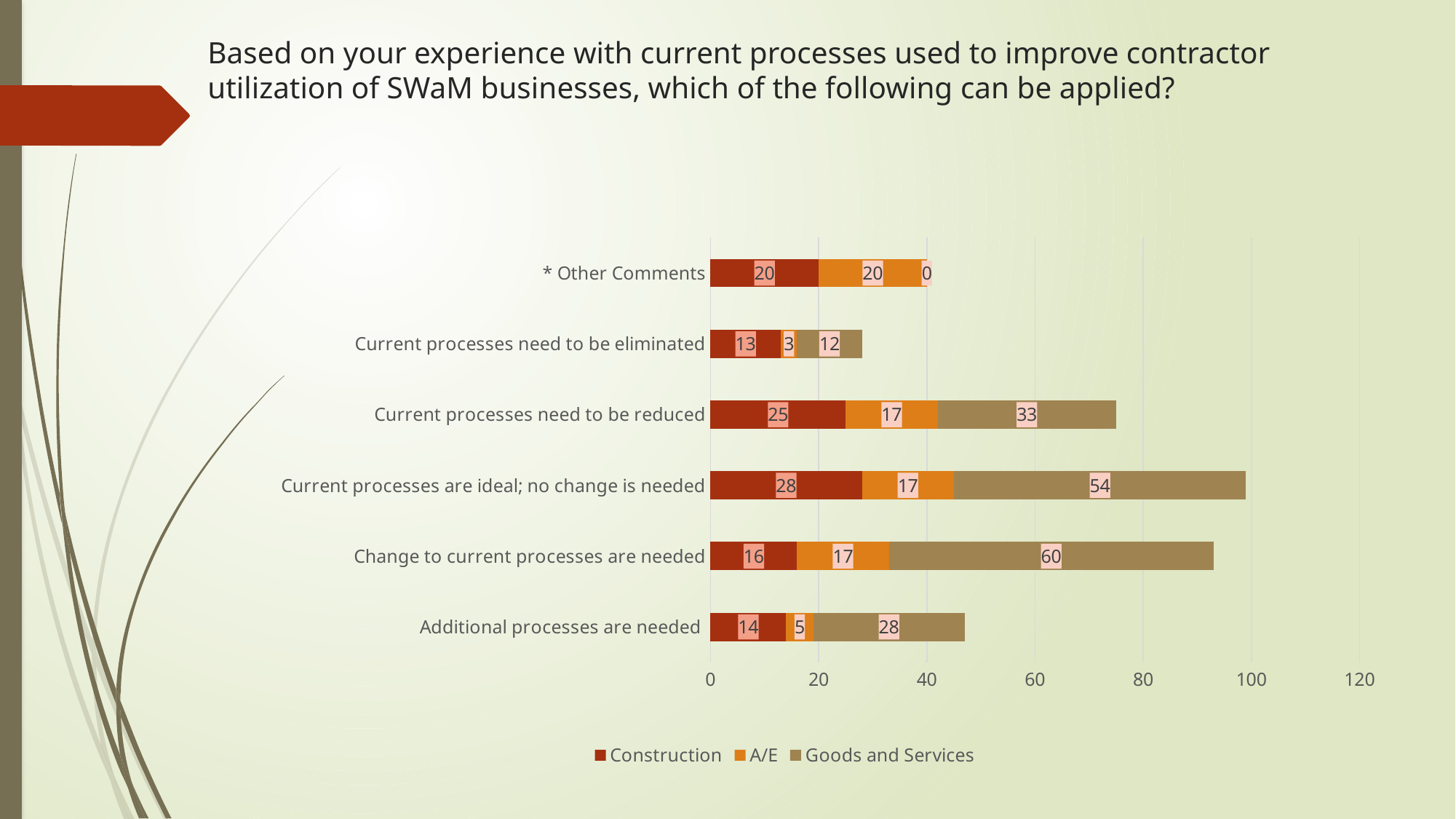
What is the Goods and Services value for "Change to current processes are needed"? 60 What is the total of the stacked bar for "Current processes are ideal; no change is needed"? 99 What kind of chart is shown on the slide? Stacked bar chart How many categories are plotted on the chart? 6 What is the difference between the Goods and Services values for "Current processes are ideal; no change is needed" and "Current processes need to be reduced"? 21 What is the A/E value for "Additional processes are needed"? 5 Which category has the highest Goods and Services value? Change to current processes are needed Which series is shown in the darkest red colour in the legend? Construction What is the Construction value for "Current processes are ideal; no change is needed"? 28 How many series does the legend list? 3 Which is larger: the Construction value for "Current processes need to be reduced" or the Construction value for "Change to current processes are needed"? Current processes need to be reduced Which category has the lowest Construction value? Current processes need to be eliminated